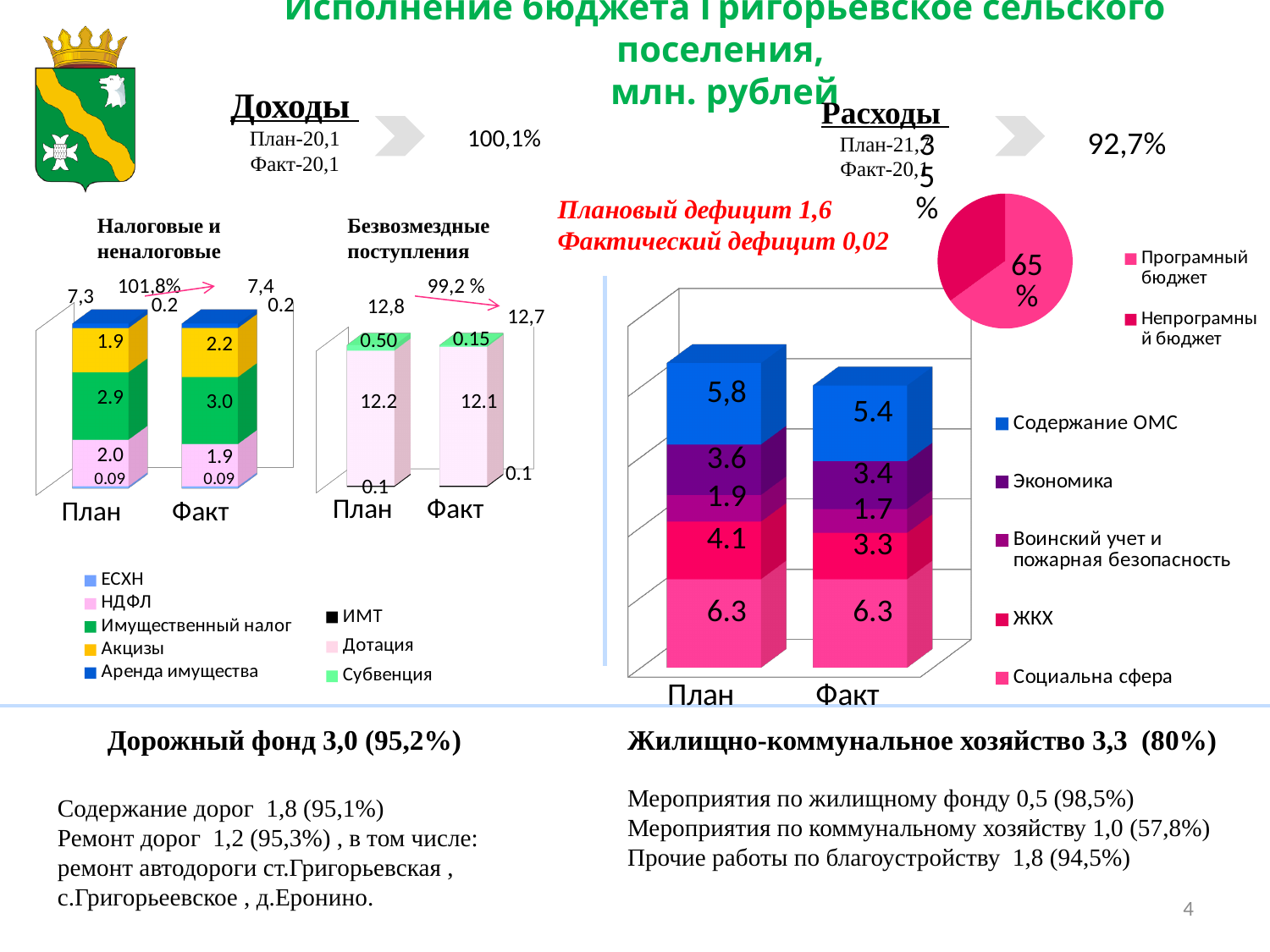
What kind of chart is the large expenses chart (Расходы) with План and Факт? Stacked bar chart In the 'Безвозмездные поступления' chart, what is the value of Дотация for План? 12.2 In the 'Налоговые и неналоговые' chart, which component is the smallest in the Факт bar? ЕСХН In the pie chart at the top right, what share does Програмный бюджет have? 65% How many series does the legend of the large expenses chart (Расходы) list? 5 In the large expenses chart (Расходы), what is the difference between the ЖКХ values for План and Факт? 0.8 In the 'Налоговые и неналоговые' chart, what is the total of the План bar? 7,3 In the 'Налоговые и неналоговые' chart, what is the value of Имущественный налог for Факт? 3.0 In the 'Безвозмездные поступления' chart, is the Субвенция value larger for План or for Факт? План In the large expenses chart (Расходы) with План and Факт bars, what is the value of Содержание ОМС for План? 5,8 In the large expenses chart (Расходы), which category has the largest value in the Факт bar? Социальна сфера In the large expenses chart (Расходы), what is the value of ЖКХ for Факт? 3.3